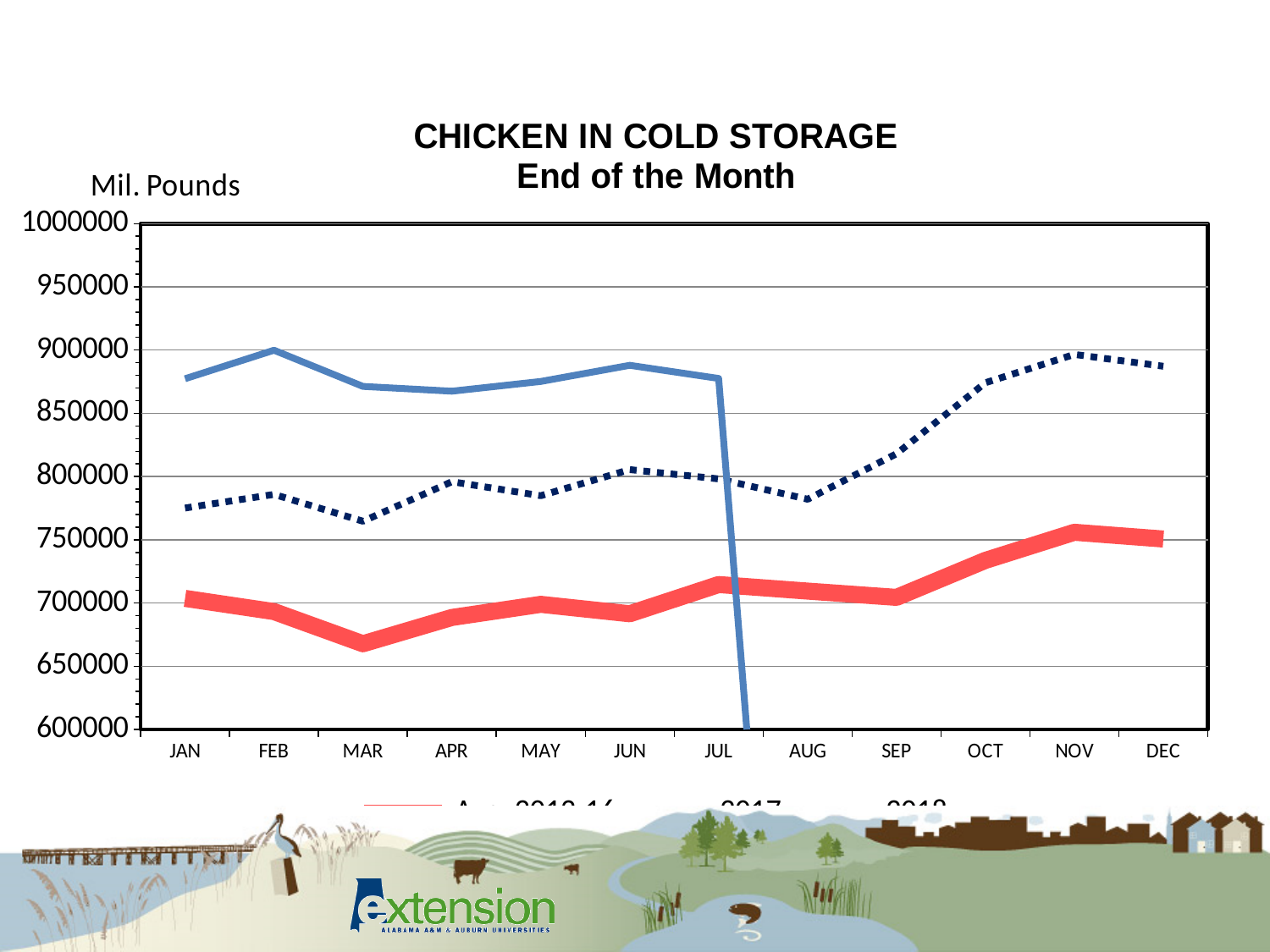
What kind of chart is shown on the slide? line chart What unit label is shown above the vertical axis? Mil. Pounds How many months are shown along the x axis? 12 Does the dotted navy line rise or fall from AUG to NOV? rise What is the title of the chart? CHICKEN IN COLD STORAGE End of the Month How many lines are plotted on the chart? 3 In which month does the thick red line reach its lowest value? MAR Is the value of the dotted navy line in MAR greater or less than 800000? less In JAN, which line has the higher value, the solid blue line or the thick red line? solid blue line Is the value of the thick red line in MAR greater or less than 700000? less Is the value of the dotted navy line in NOV greater or less than 850000? greater